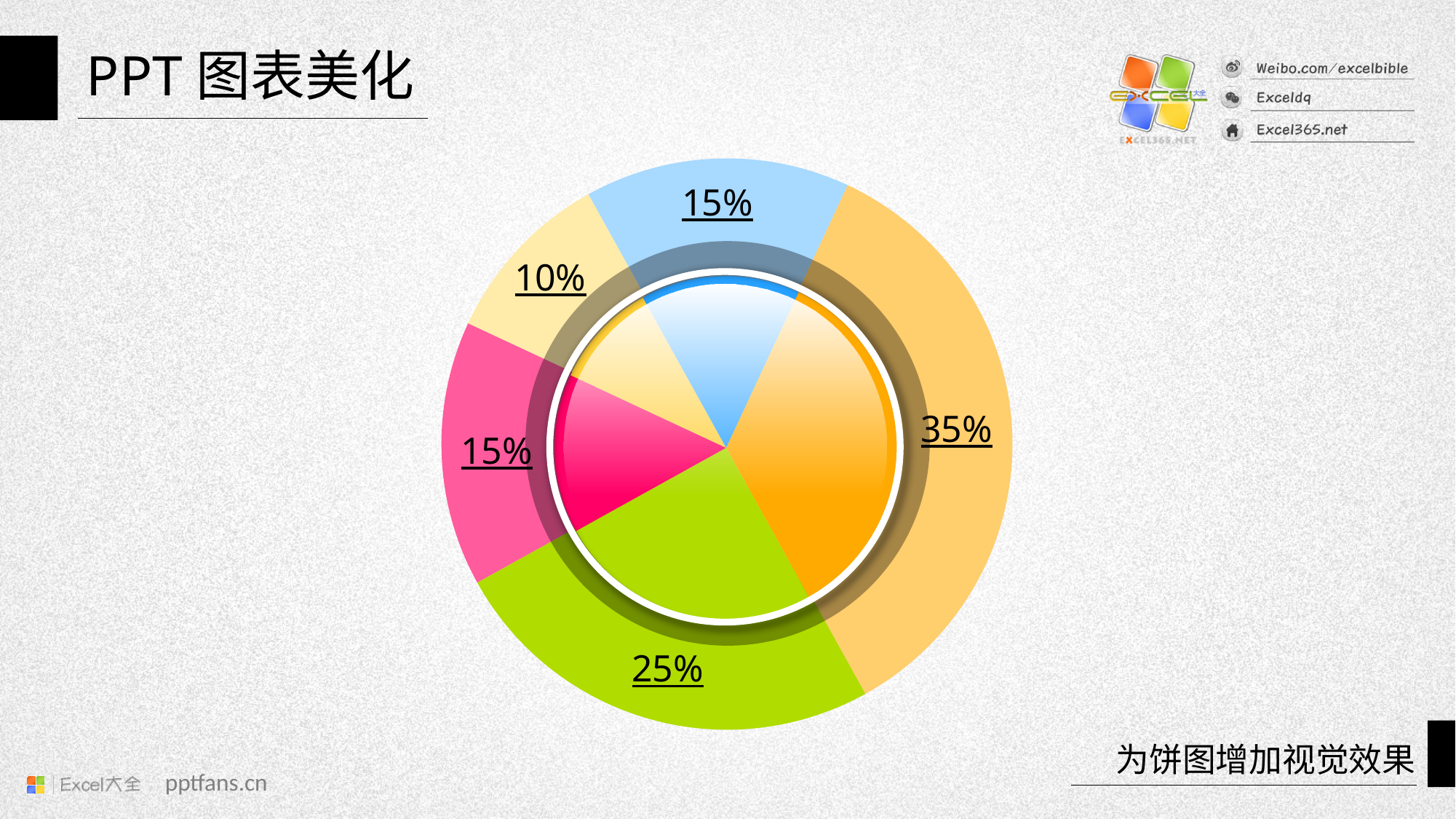
What is the title of the slide containing the pie chart? PPT 图表美化 What is the difference in percentage points between the orange slice and the green slice? 10 What percentage is shown for the light yellow slice of the pie chart? 10% What kind of chart is shown on the slide? pie chart Which colour slice has the smallest share of the pie chart? light yellow What percentage is shown for the green slice of the pie chart? 25% What is the combined share of the blue and pink slices? 30% How many slices does the pie chart have? 5 What percentage is shown for the blue slice of the pie chart? 15% Which is larger, the green slice or the pink slice? green What percentage is shown for the orange slice of the pie chart? 35% Which colour slice has the largest share of the pie chart? orange